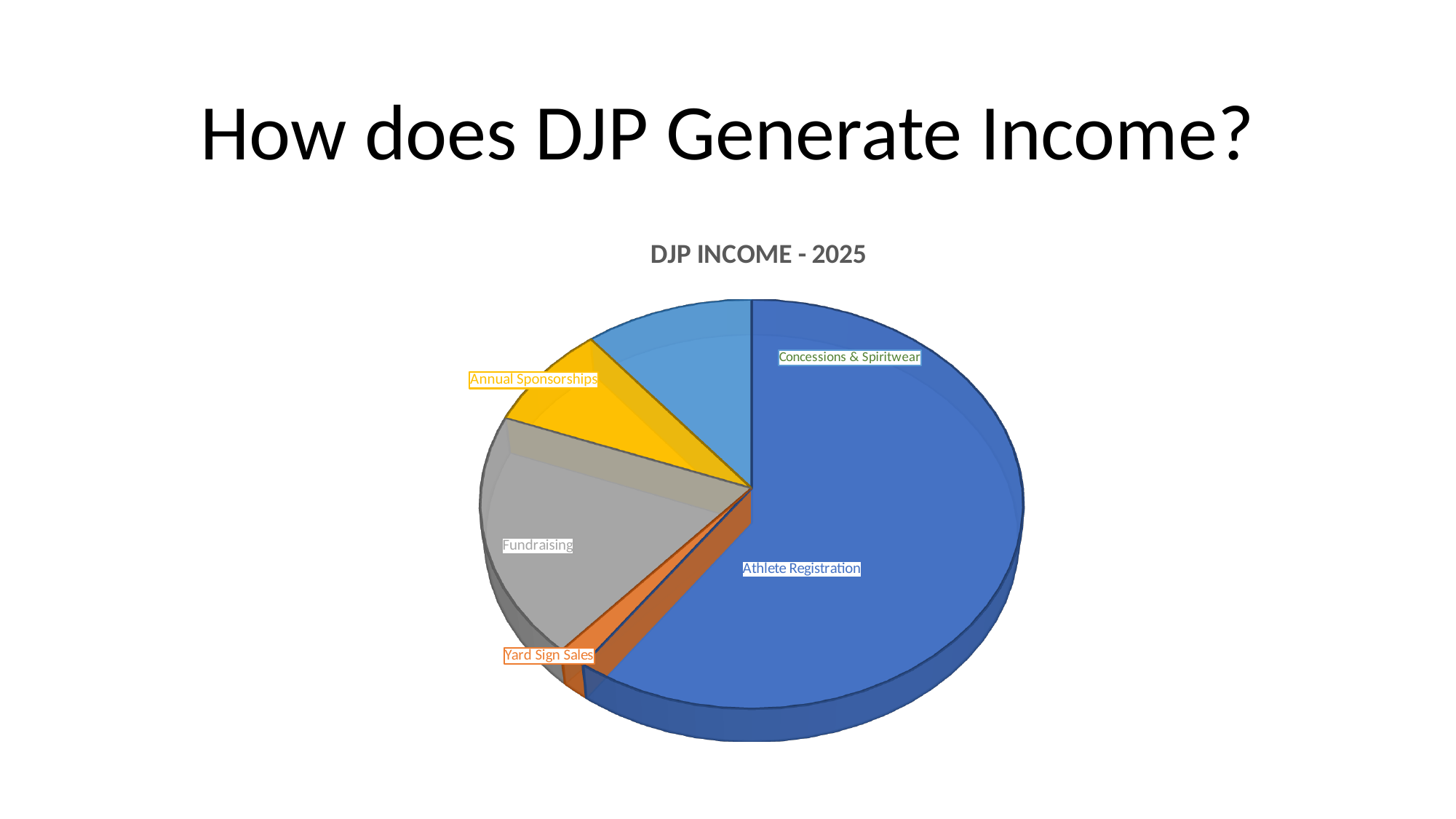
Which income source has the largest slice of the pie? Athlete Registration Which income source has the smallest slice of the pie? Yard Sign Sales Which is smaller, the Yard Sign Sales slice or the Annual Sponsorships slice? Yard Sign Sales Which is larger, the Fundraising slice or the Annual Sponsorships slice? Fundraising Which is larger, the Concessions & Spiritwear slice or the Yard Sign Sales slice? Concessions & Spiritwear What kind of chart is shown on the slide? pie chart What is the title of the chart? DJP INCOME - 2025 What colour is the Fundraising slice? gray Does the Athlete Registration slice make up more or less than half of the pie? more How many slices does the pie chart have? 5